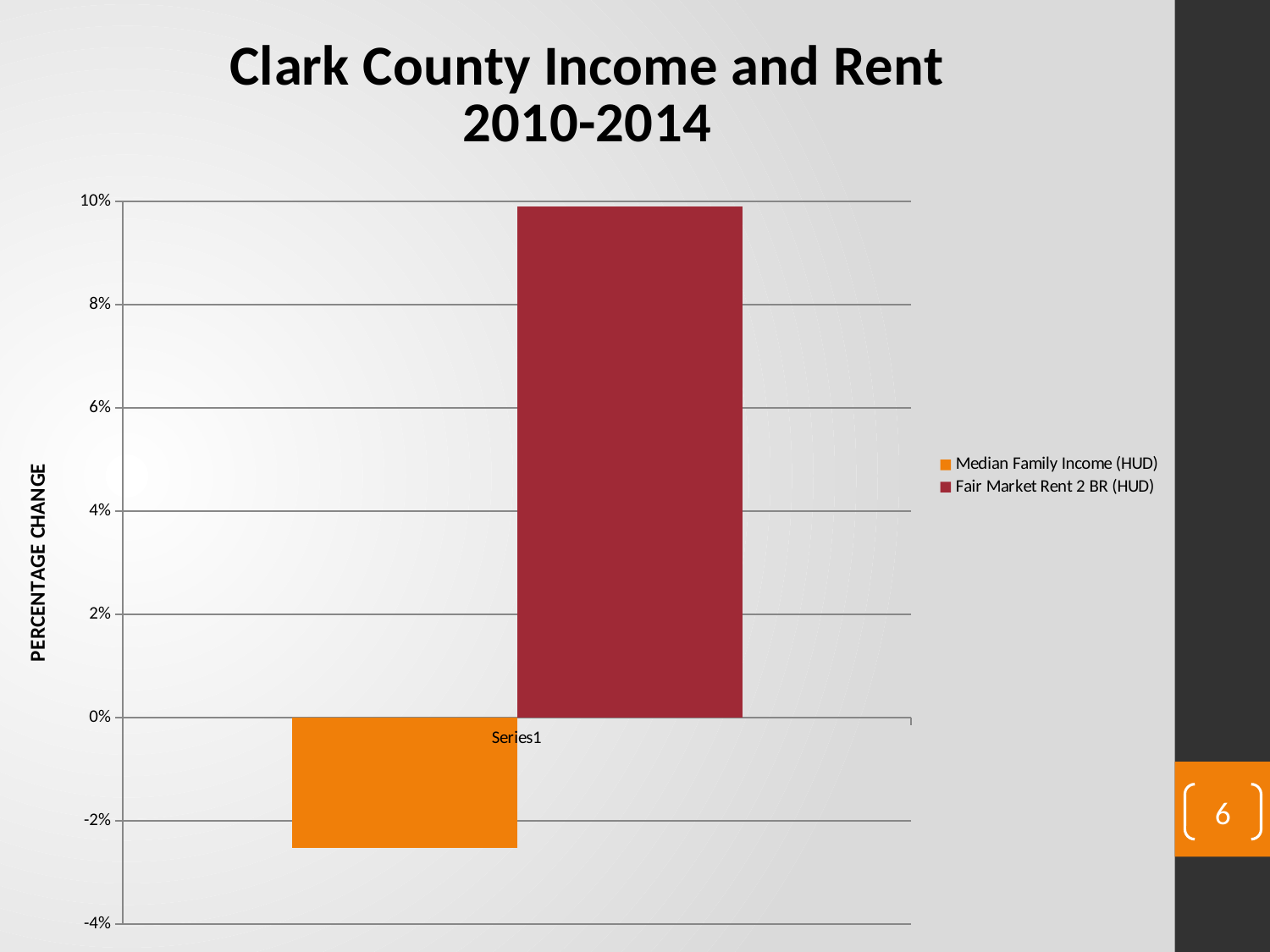
Which series has the lowest value? Median Family Income (HUD) What is the label on the vertical axis? PERCENTAGE CHANGE How many series does the legend list? 2 What is the title of the chart? Clark County Income and Rent 2010-2014 What kind of chart is shown on the slide? bar chart Is the value for Median Family Income (HUD) greater or less than -2%? less Which series has the higher value, Median Family Income (HUD) or Fair Market Rent 2 BR (HUD)? Fair Market Rent 2 BR (HUD) How many categories are shown on the x axis? 1 Is the value for Fair Market Rent 2 BR (HUD) greater or less than 8%? greater Is the value for Median Family Income (HUD) greater or less than 0%? less Which series has the highest value? Fair Market Rent 2 BR (HUD)